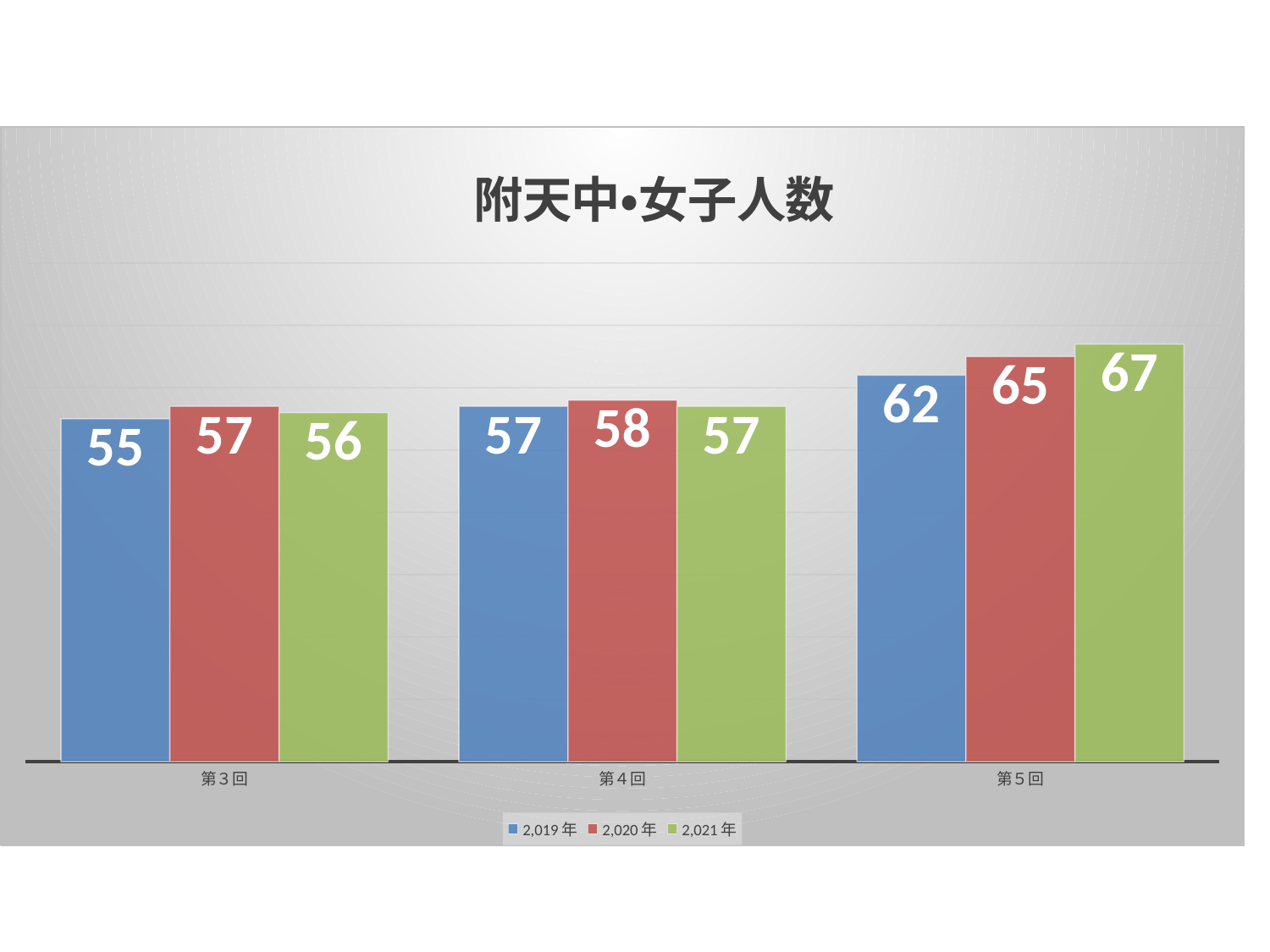
Do the 2,020年 values rise or fall from 第3回 to 第5回? Rise How many series does the legend list? 3 What kind of chart is shown on the slide? Bar chart What is the difference between the 2,021年 and 2,019年 values in 第5回? 5 What is the title of the chart? 附天中•女子人数 What is the value for 2,019年 in 第5回? 62 Which is larger in 第3回: the 2,020年 value or the 2,021年 value? 2,020年 Which category has the highest value for 2,021年? 第5回 What is the value for 2,021年 in 第3回? 56 Which category has the lowest value for 2,019年? 第3回 How many categories are shown on the x axis? 3 What is the value for 2,020年 in 第4回? 58